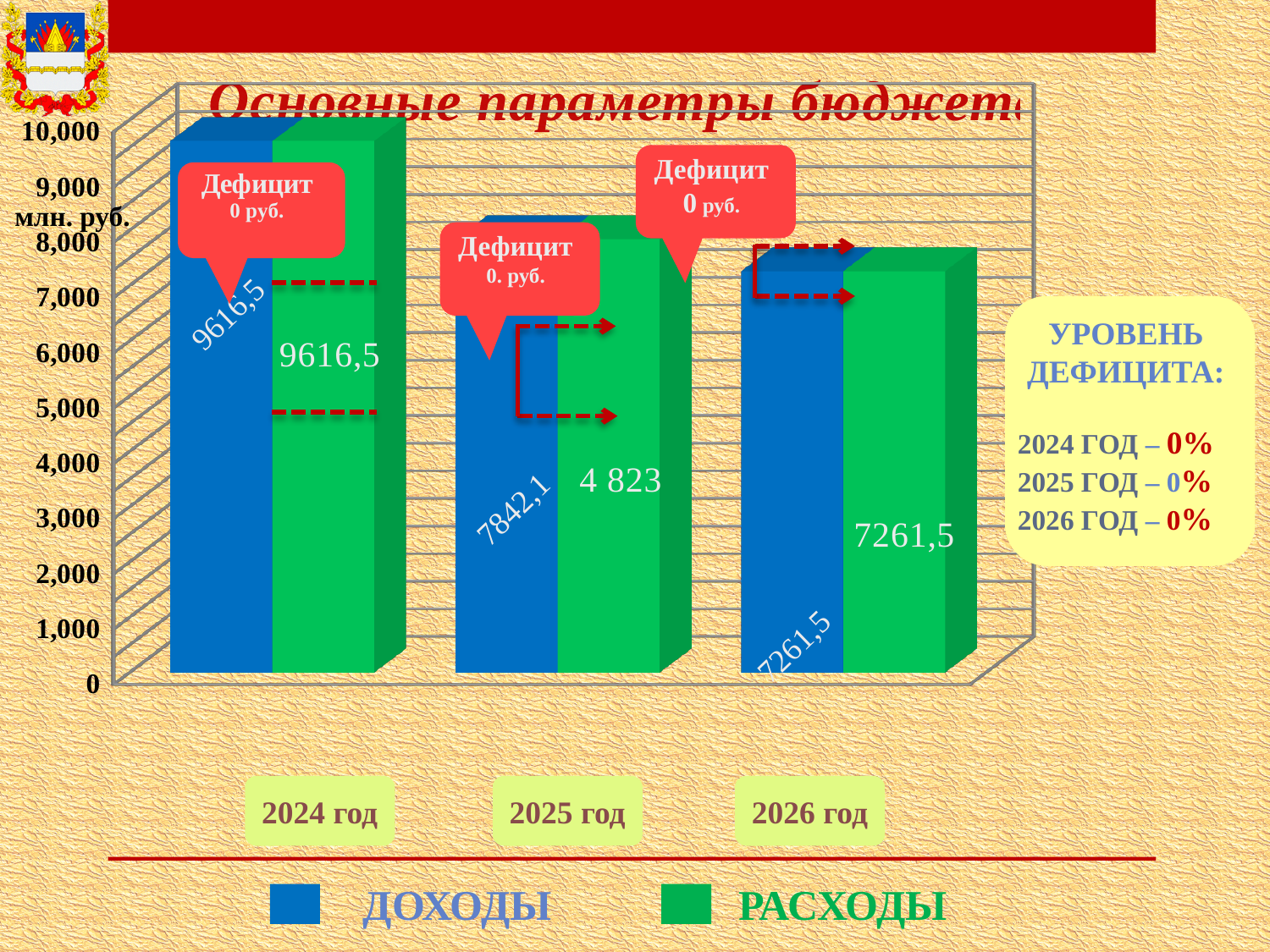
What kind of chart is shown on the slide? bar chart How many series does the legend list? 2 What is the difference between ДОХОДЫ in 2024 год and ДОХОДЫ in 2026 год? 2355 How many years (categories) are shown on the x axis? 3 Which colour represents ДОХОДЫ in the legend? blue In which year is ДОХОДЫ lowest? 2026 год Do the ДОХОДЫ values rise or fall from 2024 год to 2026 год? fall What is the value of ДОХОДЫ for 2024 год? 9616,5 What is the value of РАСХОДЫ for 2026 год? 7261,5 In which year is ДОХОДЫ highest? 2024 год What is the value of ДОХОДЫ for 2025 год? 7842,1 What is the value of РАСХОДЫ for 2024 год? 9616,5